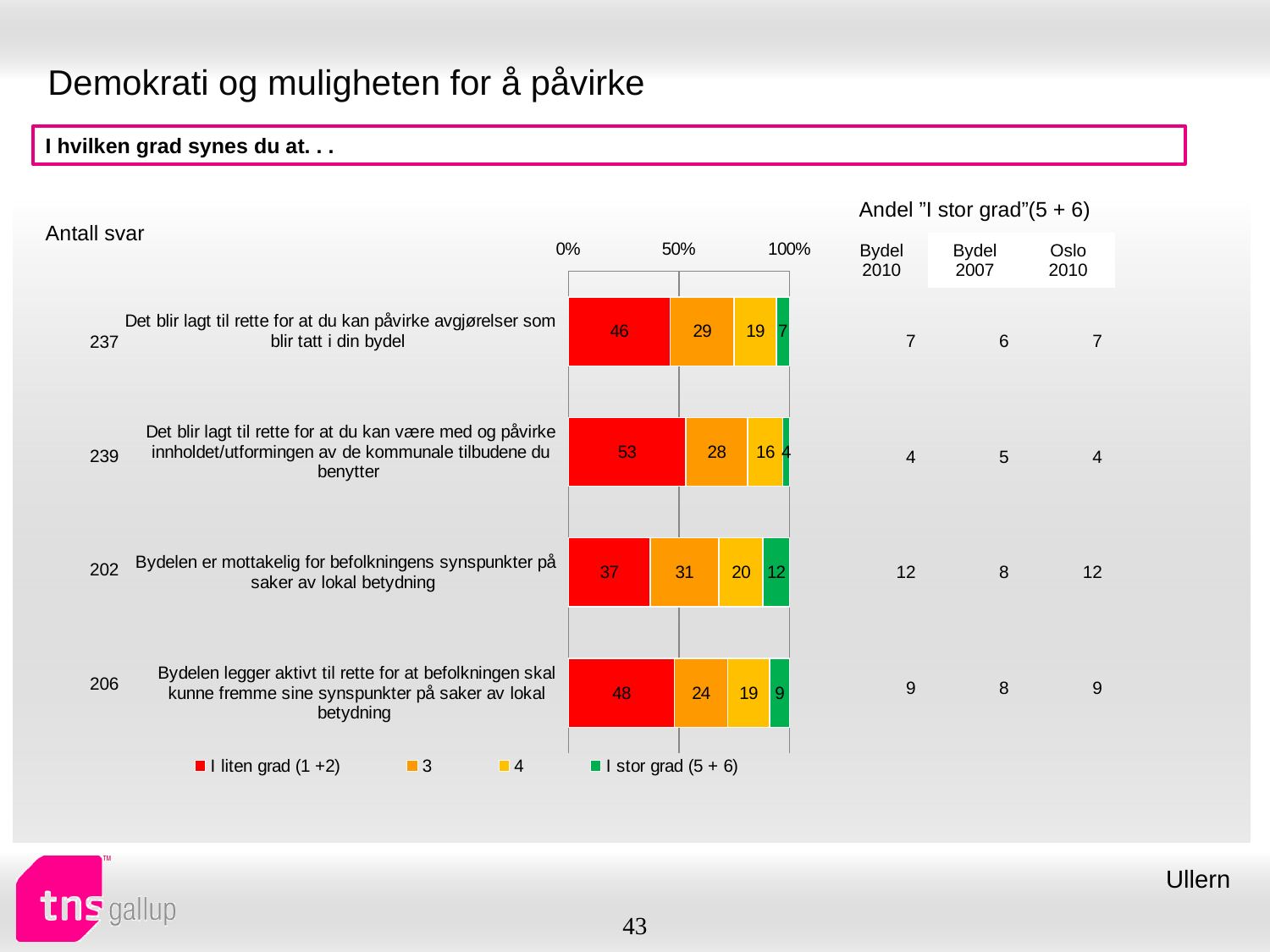
What is the value of series '3' for 'Bydelen legger aktivt til rette for at befolkningen skal kunne fremme sine synspunkter på saker av lokal betydning'? 24 Which statement has the highest value for 'I liten grad (1 +2)'? Det blir lagt til rette for at du kan være med og påvirke innholdet/utformingen av de kommunale tilbudene du benytter How many series does the chart legend list? 4 What is the difference between the 'I liten grad (1 +2)' values for 'Det blir lagt til rette for at du kan være med og påvirke innholdet/utformingen av de kommunale tilbudene du benytter' and 'Bydelen er mottakelig for befolkningens synspunkter på saker av lokal betydning'? 16 What colour represents the series 'I stor grad (5 + 6)' in the chart? green Which statement has the lowest value for 'I stor grad (5 + 6)'? Det blir lagt til rette for at du kan være med og påvirke innholdet/utformingen av de kommunale tilbudene du benytter What is the value of series '4' for 'Det blir lagt til rette for at du kan være med og påvirke innholdet/utformingen av de kommunale tilbudene du benytter'? 16 What kind of chart is shown on the slide? stacked bar chart Which is larger: the 'I stor grad (5 + 6)' value for 'Bydelen legger aktivt til rette for at befolkningen skal kunne fremme sine synspunkter på saker av lokal betydning' or for 'Det blir lagt til rette for at du kan påvirke avgjørelser som blir tatt i din bydel'? Bydelen legger aktivt til rette for at befolkningen skal kunne fremme sine synspunkter på saker av lokal betydning How many statements (categories) are plotted in the chart? 4 What is the value of 'I liten grad (1 +2)' for 'Det blir lagt til rette for at du kan påvirke avgjørelser som blir tatt i din bydel'? 46 What is the value of 'I stor grad (5 + 6)' for 'Bydelen er mottakelig for befolkningens synspunkter på saker av lokal betydning'? 12